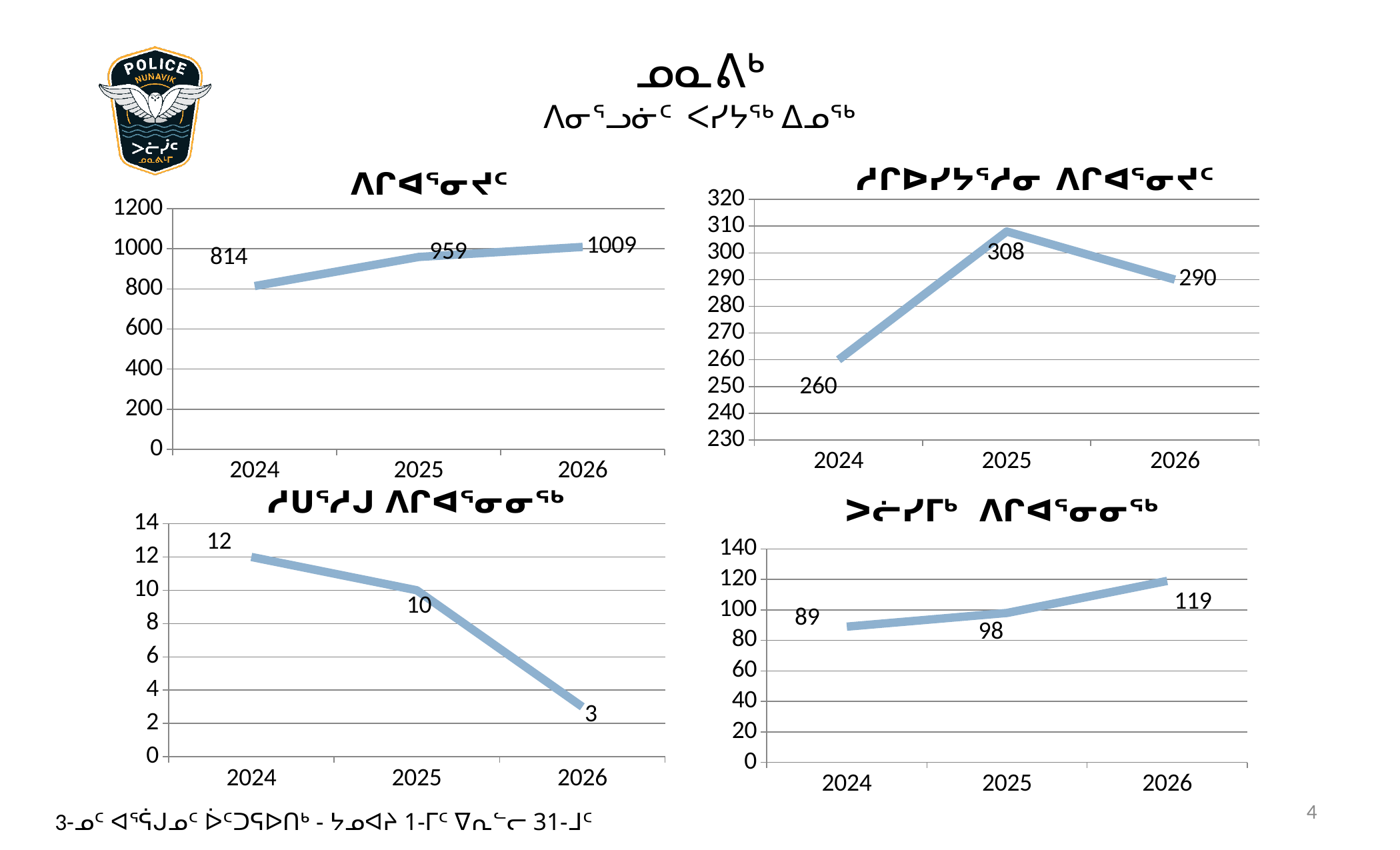
In the bottom-left chart, do the values rise or fall from 2024 to 2026? fall In the top-right chart, what is the value for 2026? 290 In the top-left chart, what is the value for 2024? 814 In the top-left chart, what is the value for 2026? 1009 In the bottom-left chart, which year has the lowest value? 2026 In the bottom-right chart, what is the value for 2025? 98 In the bottom-left chart, what is the value for 2026? 3 In the top-right chart, which year has the highest value? 2025 How many charts are on the slide, and what type are they? 4 line charts In the top-left chart, what is the difference between the 2026 and 2024 values? 195 In the top-right chart, what is the difference between the 2025 and 2024 values? 48 In the bottom-right chart, is the value for 2024 larger or smaller than the value for 2026? smaller